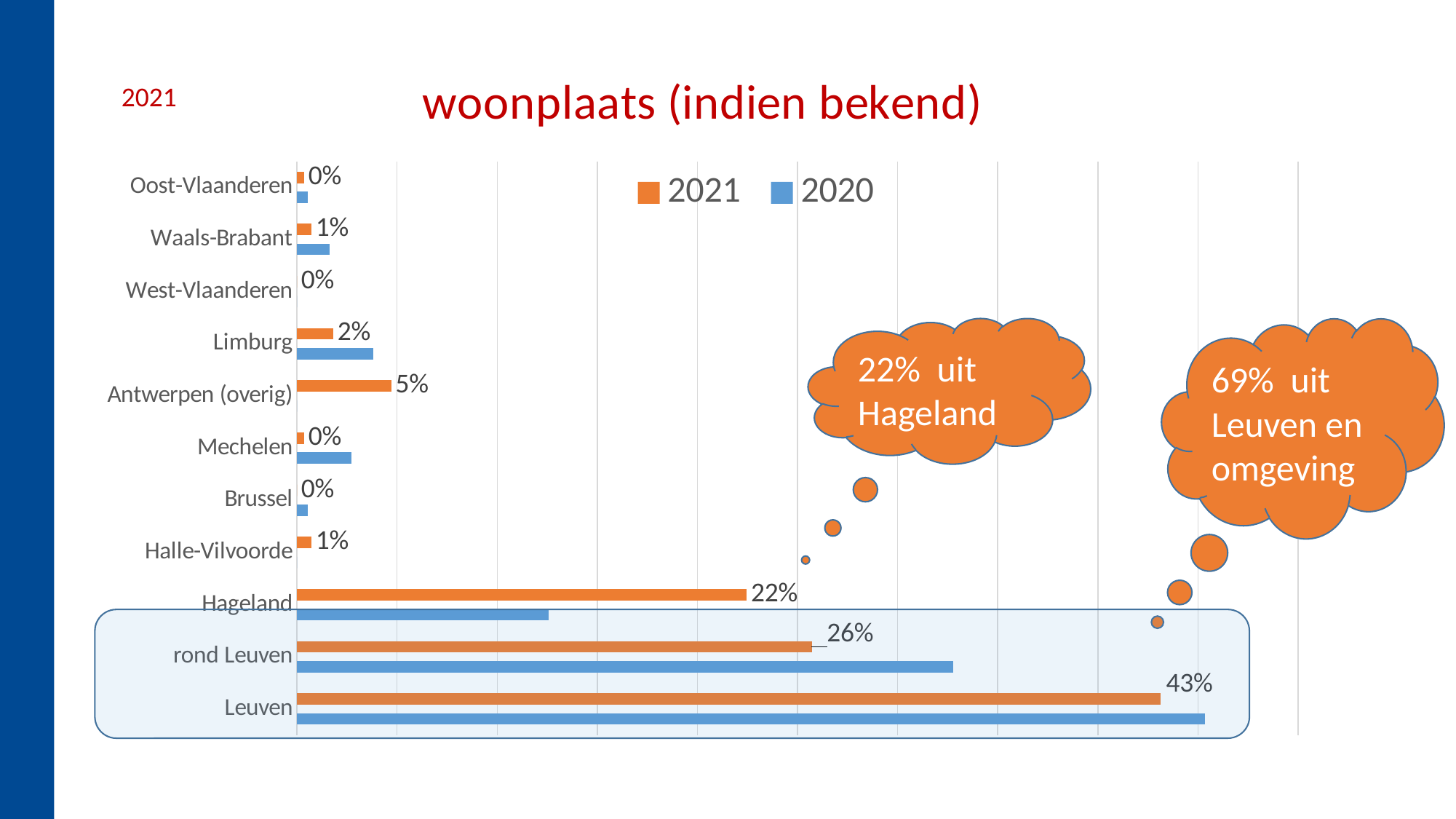
What is the difference between the 2021 values for Leuven and rond Leuven? 17% What type of chart is shown? Bar chart Which category has the highest 2021 value? Leuven For Limburg, which series has the larger value, 2021 or 2020? 2020 How many categories are shown on the chart? 11 What is the 2021 value for Hageland? 22% What is the 2021 value for Leuven? 43% For rond Leuven, which series has the larger value, 2021 or 2020? 2020 How many series does the legend list? 2 What is the 2021 value for Antwerpen (overig)? 5% What is the difference between the 2021 values for Hageland and Limburg? 20% What is the 2021 value for rond Leuven? 26%